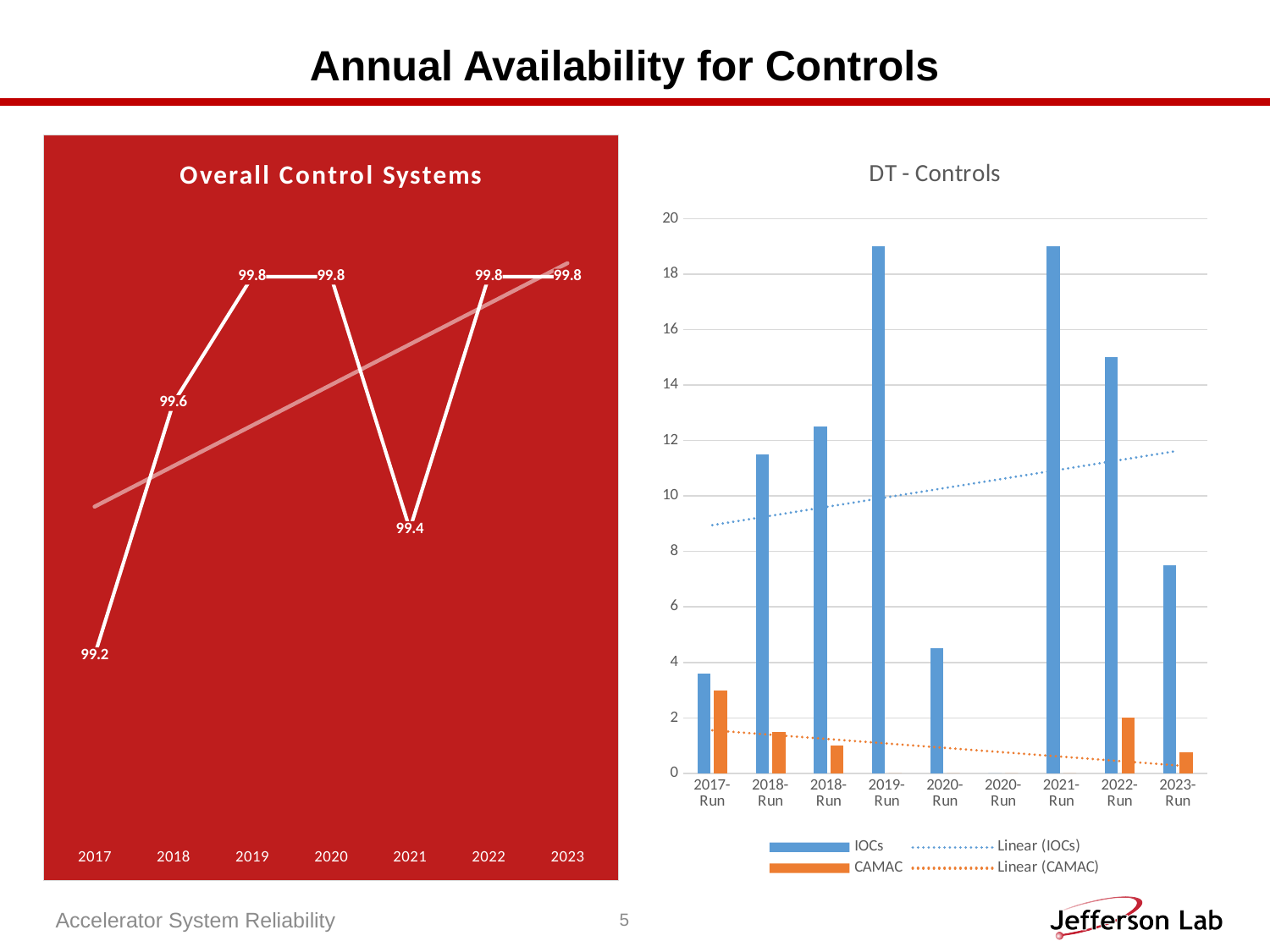
What kind of chart is the Overall Control Systems chart? Line chart In the DT - Controls chart, is the IOCs value for 2023-Run greater or less than 8? less In the DT - Controls chart, is the IOCs value for 2019-Run greater or less than 18? greater In the Overall Control Systems chart, what is the value for 2021? 99.4 In the Overall Control Systems chart, which year has the lowest value? 2017 In the Overall Control Systems chart, which is larger, the value for 2018 or the value for 2021? 2018 How many entries does the legend of the DT - Controls chart list? 4 In the DT - Controls chart, which is larger, the IOCs value for 2022-Run or the IOCs value for 2023-Run? 2022-Run In the Overall Control Systems chart, what is the value for 2017? 99.2 In the Overall Control Systems chart, what is the difference between the values for 2019 and 2017? 0.6 How many years are plotted in the Overall Control Systems chart? 7 In the Overall Control Systems chart, what is the value for 2018? 99.6